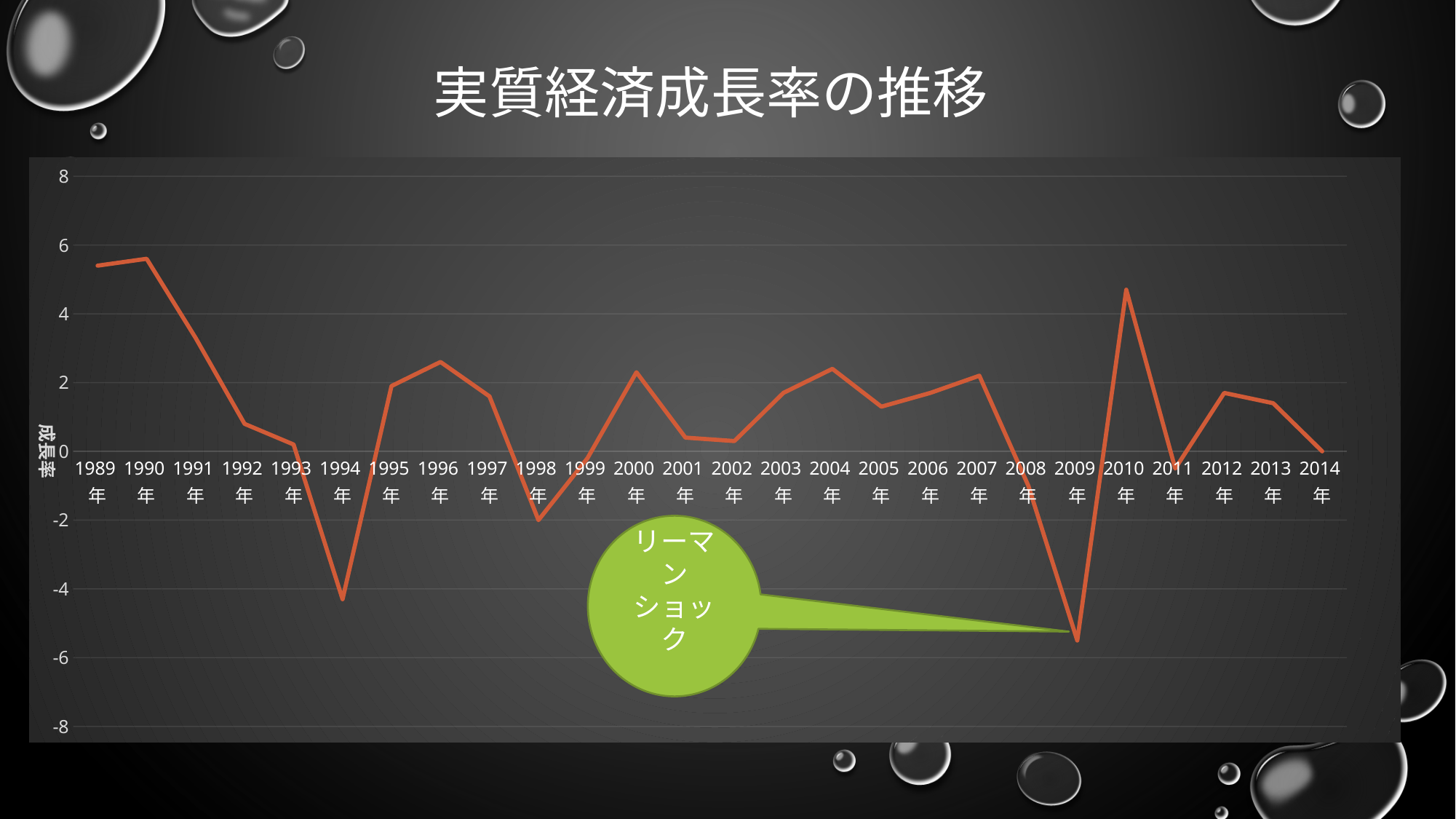
How many years are plotted along the x axis of the chart? 26 What kind of chart is shown on the slide? line chart Is the value for 2009年 greater or less than -4? less Is the value for 1989年 greater or less than 4? greater Which year has the lowest value on the chart? 2009年 Is the value for 1994年 greater or less than -2? less Do the values rise or fall from 1990年 to 1994年? fall What text is in the green callout pointing at the 2009年 point? リーマンショック Which year has the larger value, 1994年 or 1998年? 1998年 Which year has the larger value, 2010年 or 2011年? 2010年